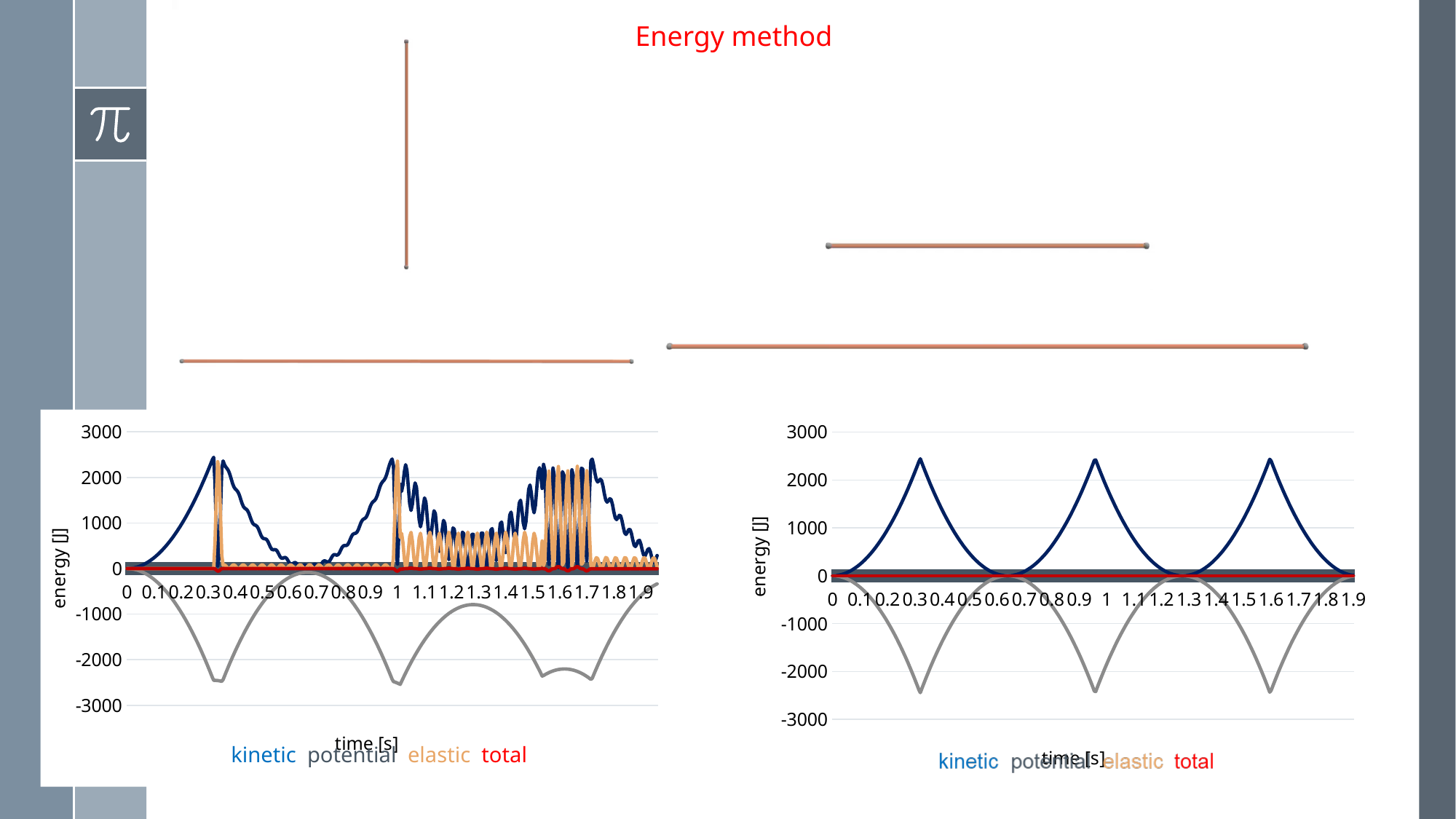
In the left chart, which series reaches a higher value at 0.3 s, kinetic or total? kinetic In the right chart, does the kinetic series rise or fall between 0 s and 0.3 s? rise In the left chart, is the value of the total series at 1 s greater or less than 1000? less In the right chart, does the potential series rise or fall between 0 s and 0.3 s? fall How many series does the legend of the right chart list? 4 In the right chart, is the lowest value of the potential series near 0.3 s greater or less than -2000? less How many tick labels are shown on the x axis of the right chart? 20 What is the y-axis label of the left chart? energy [J] In the right chart, is the peak value of the kinetic series near 0.3 s greater or less than 2000? greater What kind of chart is the left chart on the slide? line chart What is the x-axis label of the right chart? time [s]